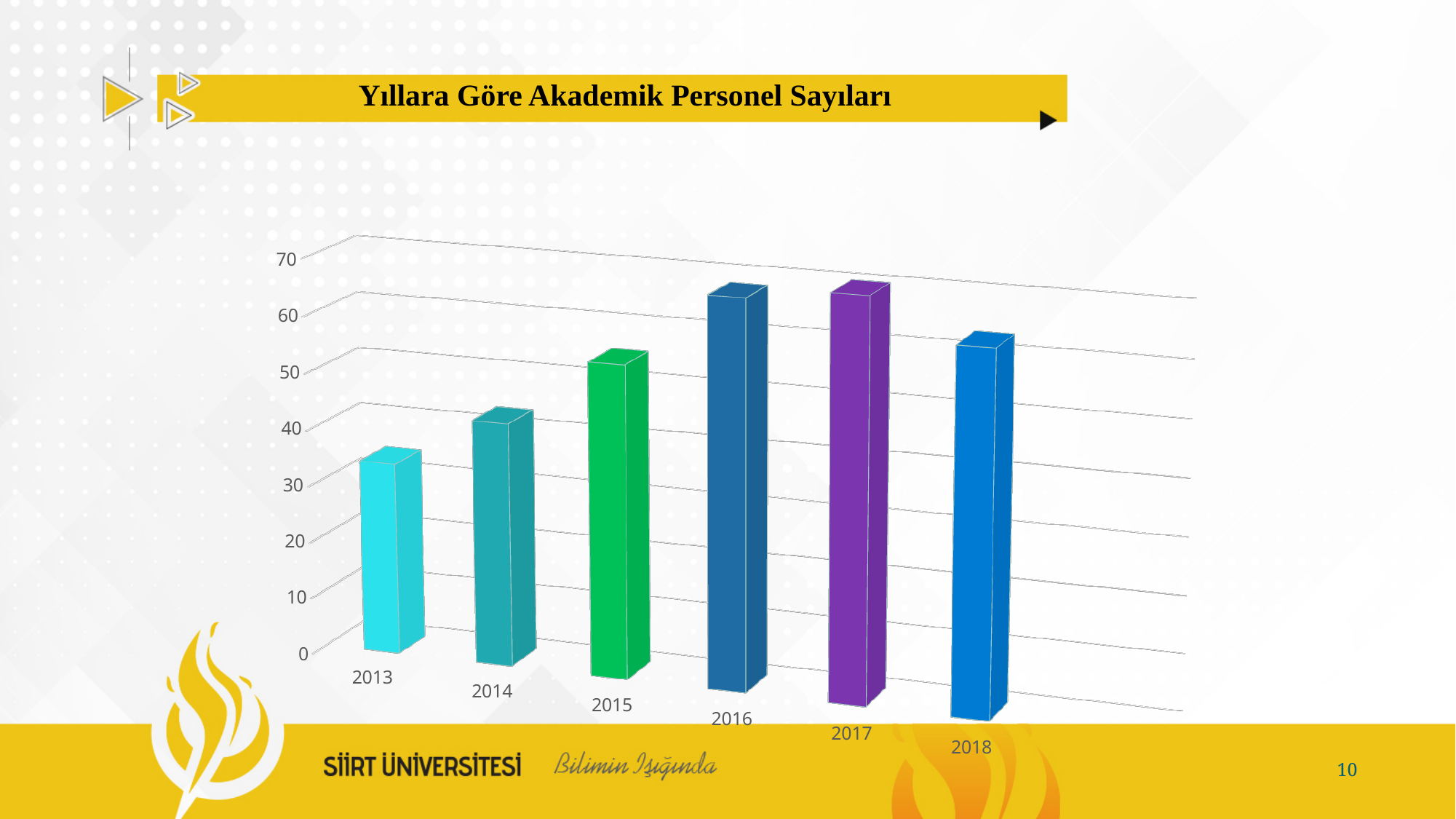
Which is larger, the value for 2013 or the value for 2016? 2016 Which is larger, the value for 2014 or the value for 2018? 2018 What kind of chart is shown on the slide? bar chart How many years are shown on the x axis of the chart? 6 Is the value for 2014 greater or less than 50? less Which year has the lowest value in the chart? 2013 Is the value for 2016 greater or less than 50? greater Is the value for 2018 greater or less than 40? greater What is the title of the chart? Yıllara Göre Akademik Personel Sayıları